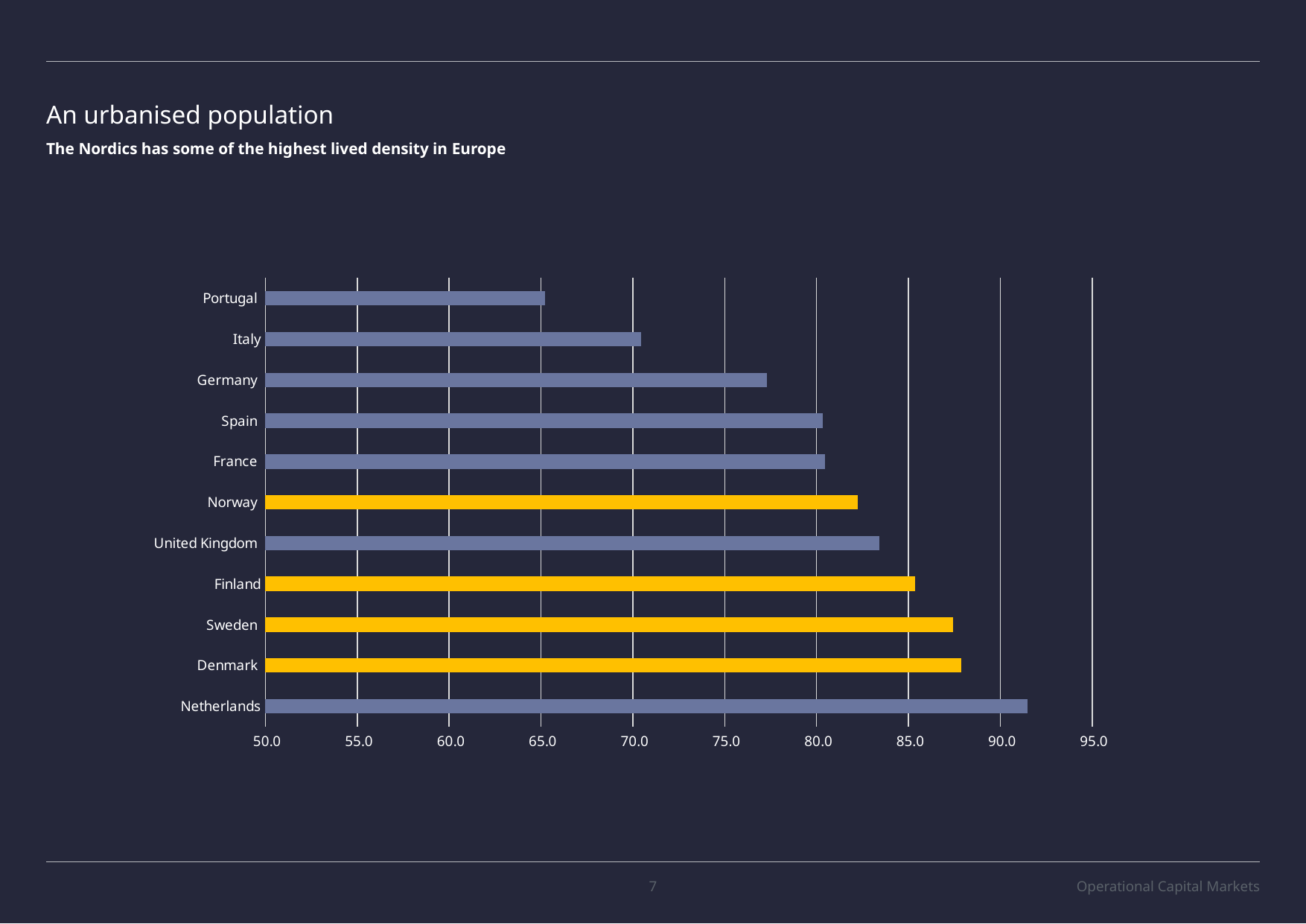
Is the value for Portugal greater or less than 70.0? less Is the value for Germany greater or less than 75.0? greater Which country has the lowest value in the chart? Portugal Is the value for Netherlands greater or less than 90.0? greater Which countries' bars are highlighted in yellow in the chart? Norway, Finland, Sweden, Denmark Which has a larger value, Sweden or United Kingdom? Sweden Which country has the highest value in the chart? Netherlands What kind of chart is shown on the slide? bar chart How many countries are shown in the chart? 11 Which has a larger value, Norway or Germany? Norway